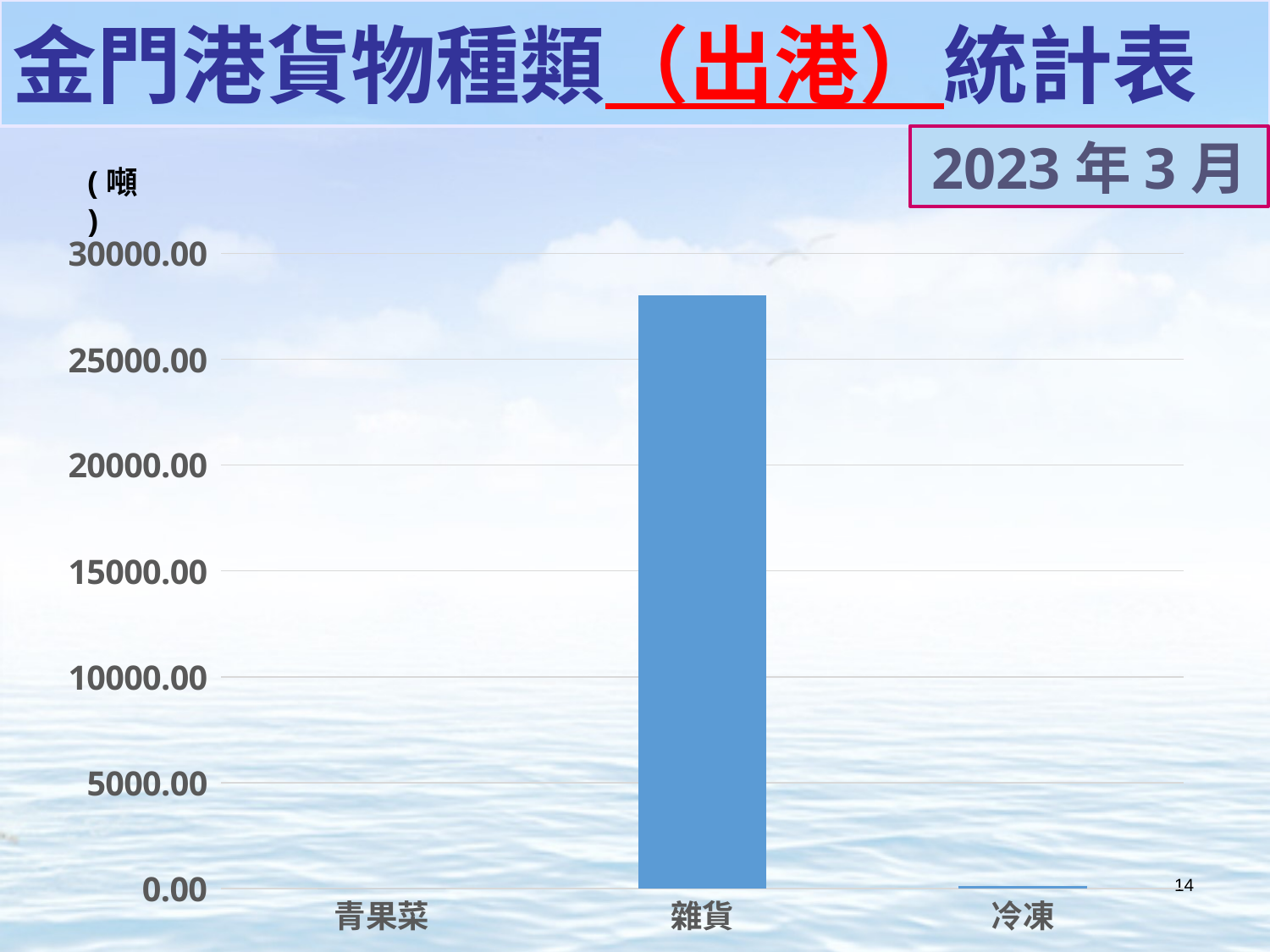
What is the highest tick value shown on the y axis? 30000.00 Which is larger, the value for 雜貨 or the value for 冷凍? 雜貨 Is the value for 雜貨 greater or less than 25000.00? greater Is the value for 雜貨 greater or less than 30000.00? less Is the value for 青果菜 greater or less than 5000.00? less What is the title of the chart on the slide? 金門港貨物種類（出港）統計表 How many categories are shown on the x axis of the chart? 3 Which is larger, the value for 雜貨 or the value for 青果菜? 雜貨 What kind of chart is shown on the slide? bar chart What unit is shown for the y axis of the chart? 噸 Which category has the highest value in the chart? 雜貨